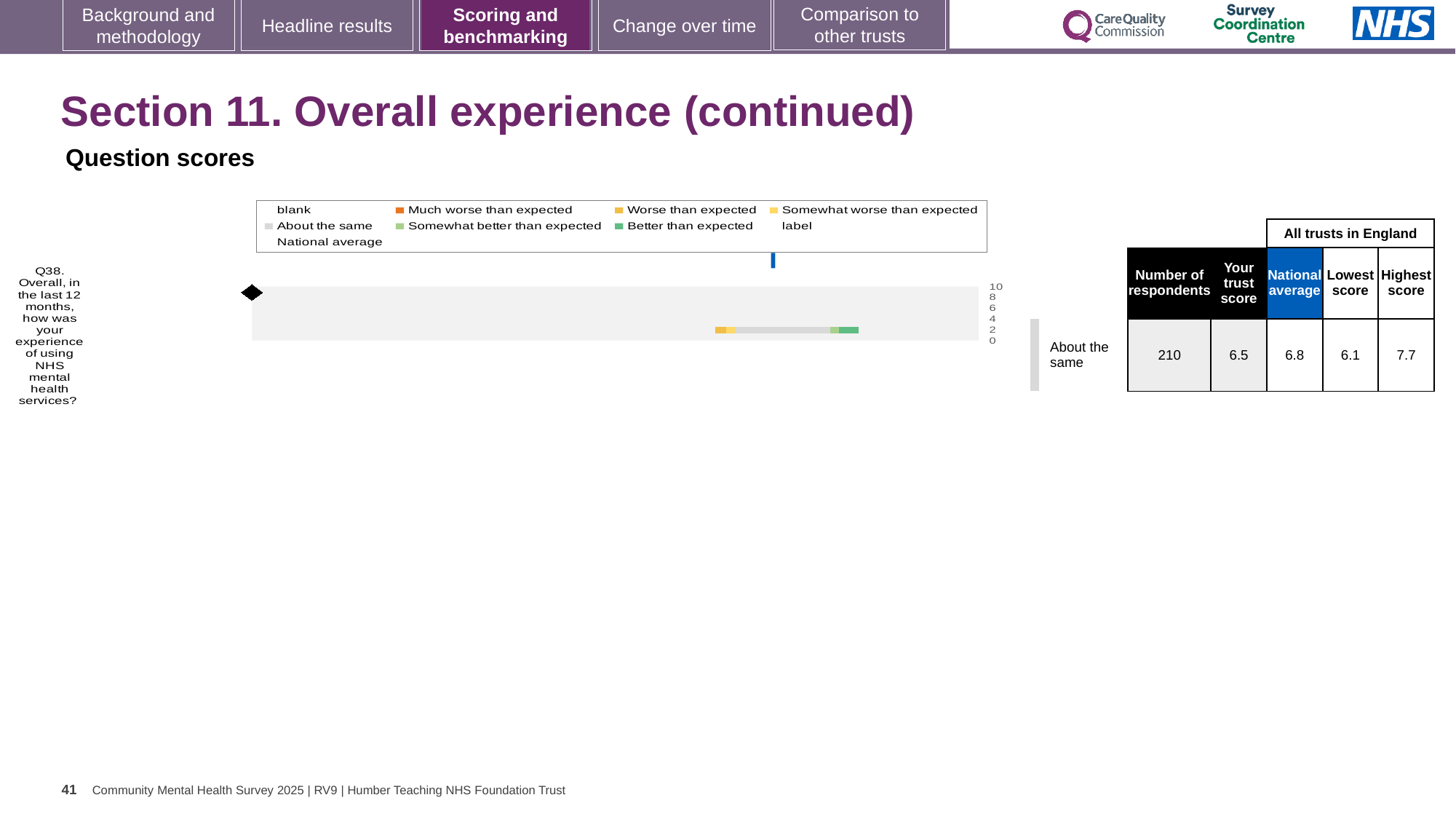
Which question number is plotted on the chart? Q38 What benchmark category is shown for Q38 next to the chart? About the same What is the number of respondents for Q38? 210 Which is larger for Q38, the trust score or the national average? national average What kind of chart is used to show the Q38 question score? bar chart What is the difference between the highest and lowest scores for Q38? 1.6 What is the trust score for Q38? 6.5 What is the lowest score among all trusts in England for Q38? 6.1 How many survey questions are plotted on the chart? 1 What is the national average score for Q38? 6.8 What is the highest score among all trusts in England for Q38? 7.7 What is the difference between the national average and the trust score for Q38? 0.3